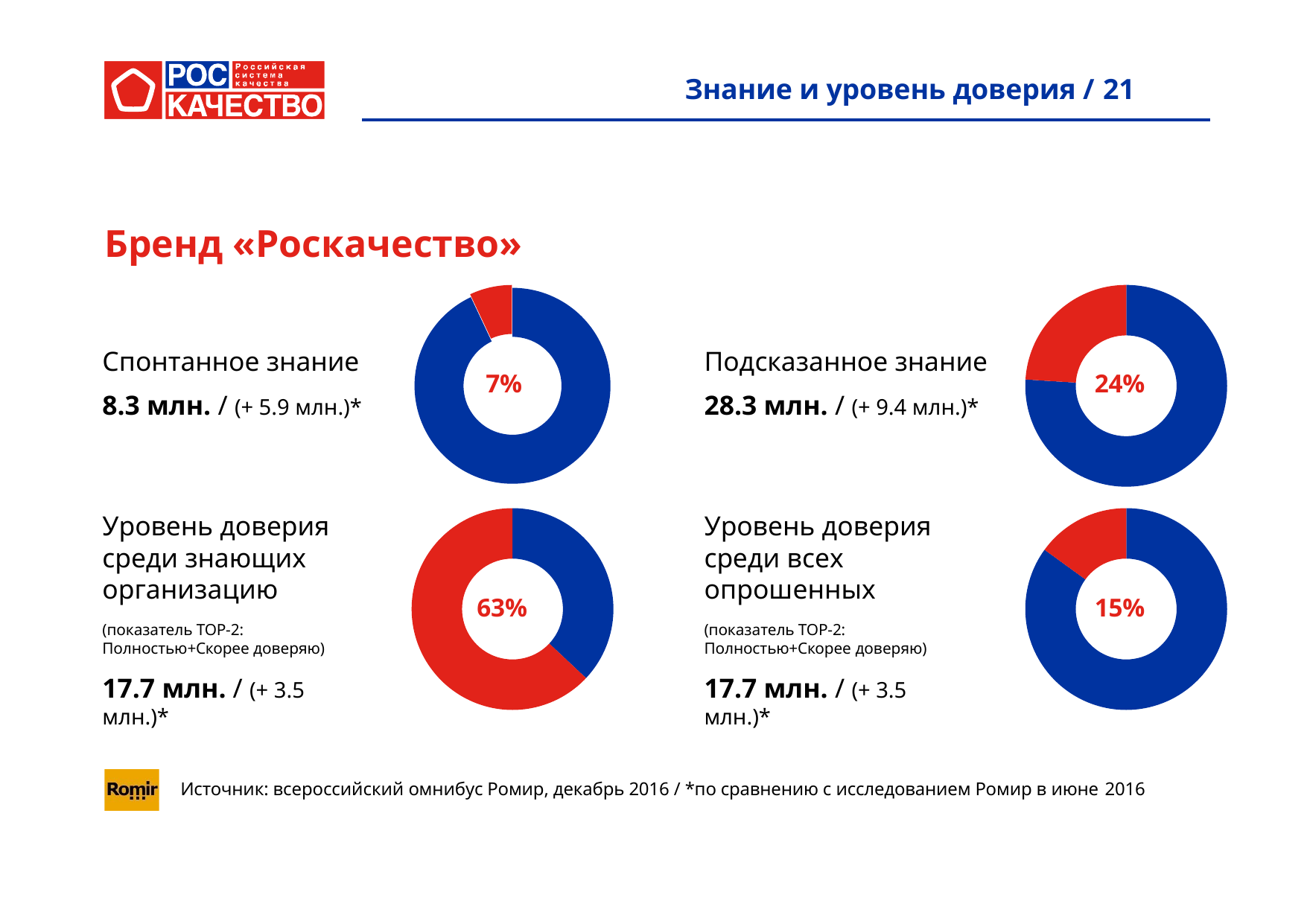
In the donut chart for «Уровень доверия среди знающих организацию», what share of the ring is the red slice? 63% What percentage is shown in the donut chart for «Уровень доверия среди знающих организацию»? 63% What is the difference between the percentage for «Подсказанное знание» and the percentage for «Спонтанное знание»? 17% What percentage is shown in the centre of the donut chart for «Подсказанное знание»? 24% What percentage is shown in the donut chart for «Уровень доверия среди всех опрошенных»? 15% Which of the four donut charts on the slide shows the lowest percentage? Спонтанное знание (7%) Which of the four donut charts on the slide shows the highest percentage? Уровень доверия среди знающих организацию (63%) Which is larger: the percentage for «Уровень доверия среди знающих организацию» or for «Уровень доверия среди всех опрошенных»? Уровень доверия среди знающих организацию How many donut charts are shown on the slide? 4 What type of chart is used to show the percentages on this slide? Donut (pie) chart What percentage is shown in the centre of the donut chart for «Спонтанное знание»? 7% What colour is the slice representing the highlighted percentage in each donut chart? Red